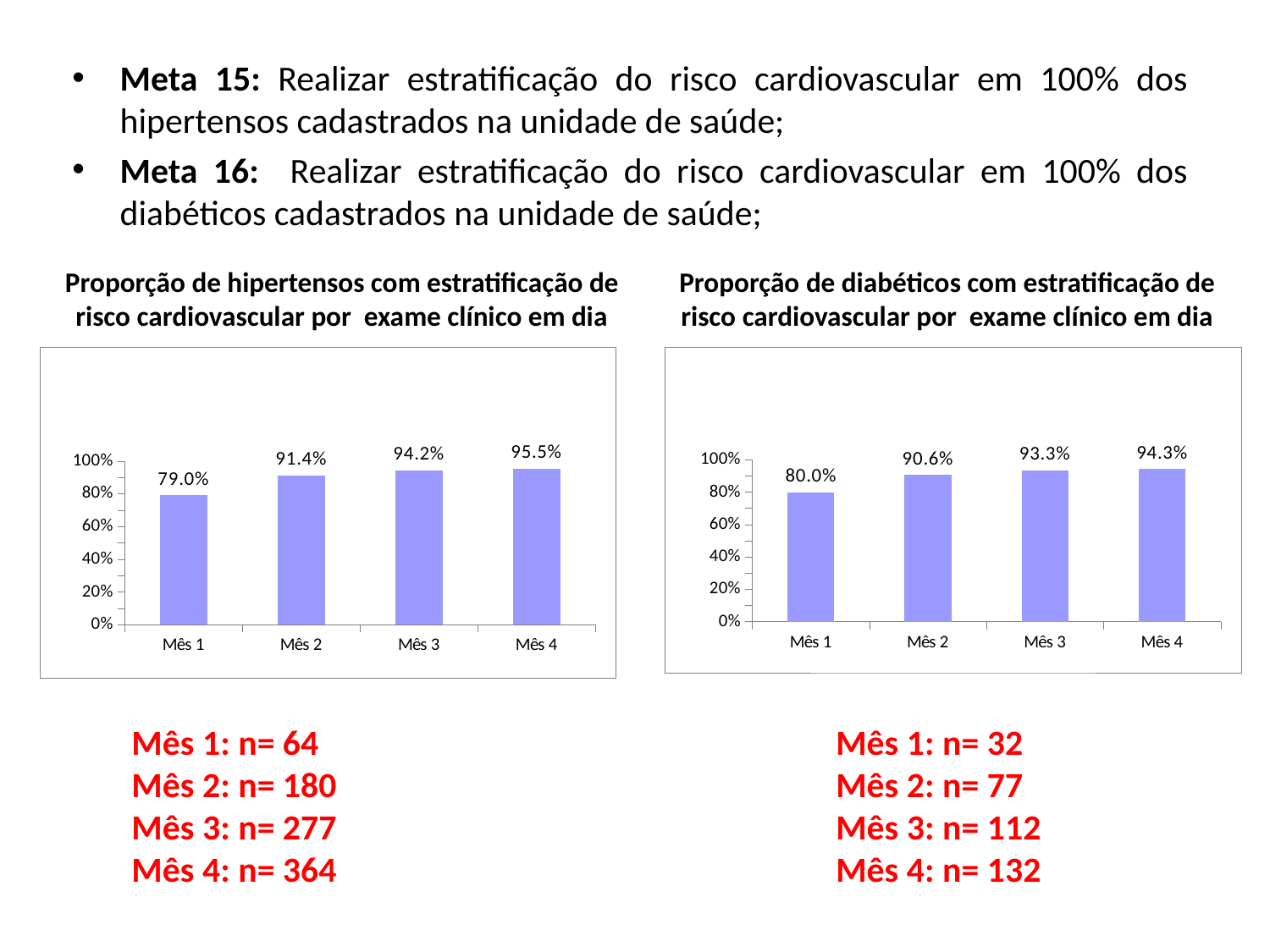
In the chart 'Proporção de hipertensos com estratificação de risco cardiovascular por exame clínico em dia', is the value for Mês 1 greater or less than 80%? less In the chart 'Proporção de diabéticos com estratificação de risco cardiovascular por exame clínico em dia', which month has the lowest value? Mês 1 In the chart 'Proporção de diabéticos com estratificação de risco cardiovascular por exame clínico em dia', what is the value for Mês 3? 93.3% What kind of chart is 'Proporção de hipertensos com estratificação de risco cardiovascular por exame clínico em dia'? Bar chart How many months are shown on the x axis of the chart 'Proporção de diabéticos com estratificação de risco cardiovascular por exame clínico em dia'? 4 Which is larger: the Mês 2 value in the hipertensos chart (left) or the Mês 2 value in the diabéticos chart (right)? Hipertensos chart (91.4%) In the chart 'Proporção de diabéticos com estratificação de risco cardiovascular por exame clínico em dia', do the values rise or fall from Mês 1 to Mês 4? Rise In the chart 'Proporção de hipertensos com estratificação de risco cardiovascular por exame clínico em dia', what is the value for Mês 1? 79.0% In the chart 'Proporção de diabéticos com estratificação de risco cardiovascular por exame clínico em dia', what is the difference between the values for Mês 4 and Mês 1? 14.3% What is the title of the chart on the right side of the slide? Proporção de diabéticos com estratificação de risco cardiovascular por exame clínico em dia In the chart 'Proporção de hipertensos com estratificação de risco cardiovascular por exame clínico em dia', which month has the highest value? Mês 4 In the chart 'Proporção de hipertensos com estratificação de risco cardiovascular por exame clínico em dia', what is the difference between the values for Mês 2 and Mês 1? 12.4%